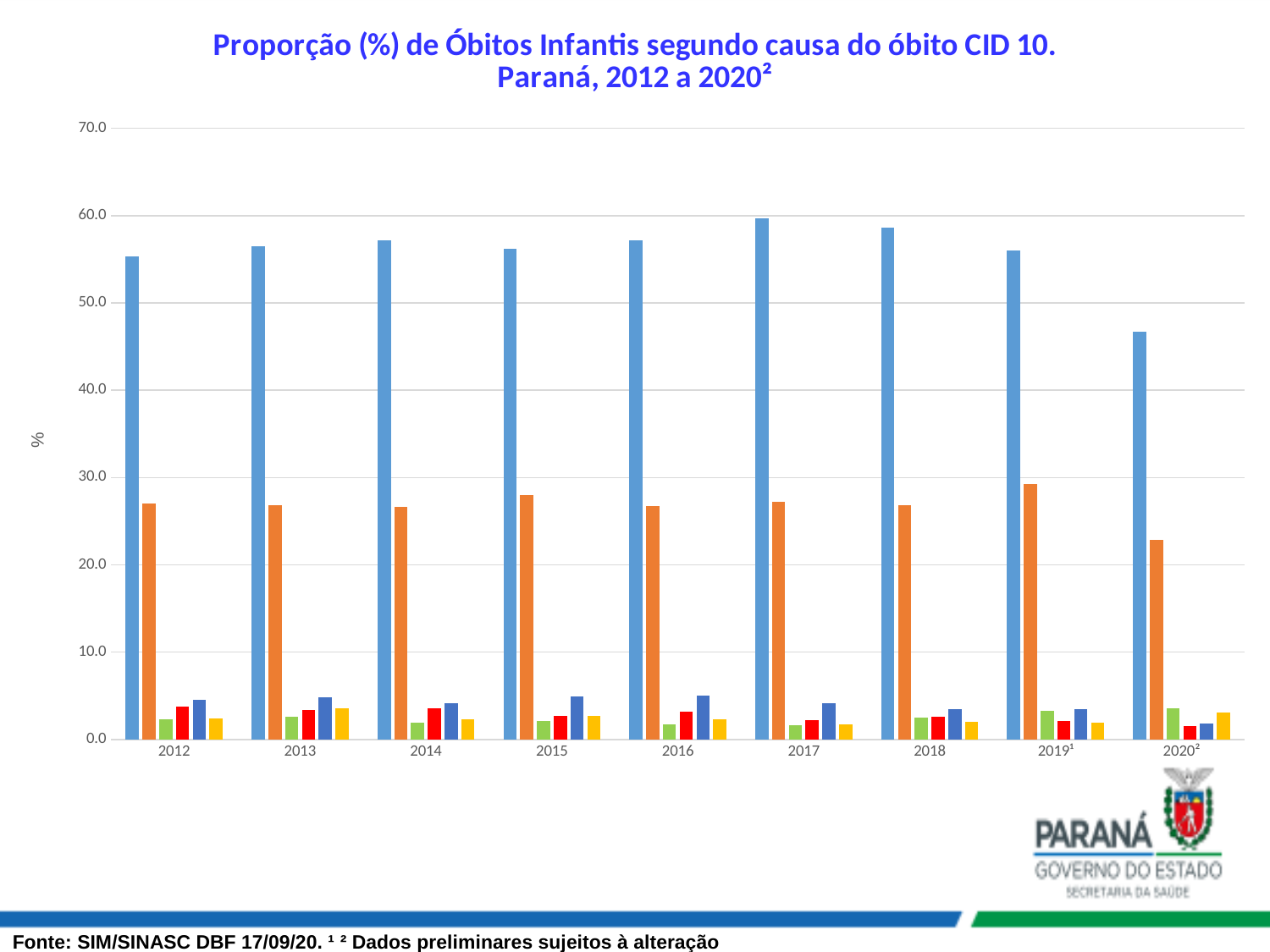
Is the value of the light blue bar for 2017 greater or less than 50.0? greater In 2012, which is larger: the light blue bar or the orange bar? the light blue bar Is the value of the orange bar for 2019¹ greater or less than 20.0? greater What is the label on the vertical axis? % In which year is the light blue bar the tallest? 2017 In which year is the orange bar the shortest? 2020² What kind of chart is shown on the slide? bar chart In which year is the light blue bar the shortest? 2020² In which year is the orange bar the tallest? 2019¹ Is the value of the light blue bar for 2020² greater or less than 50.0? less How many bars are plotted for each year? 6 How many years are shown along the x axis? 9